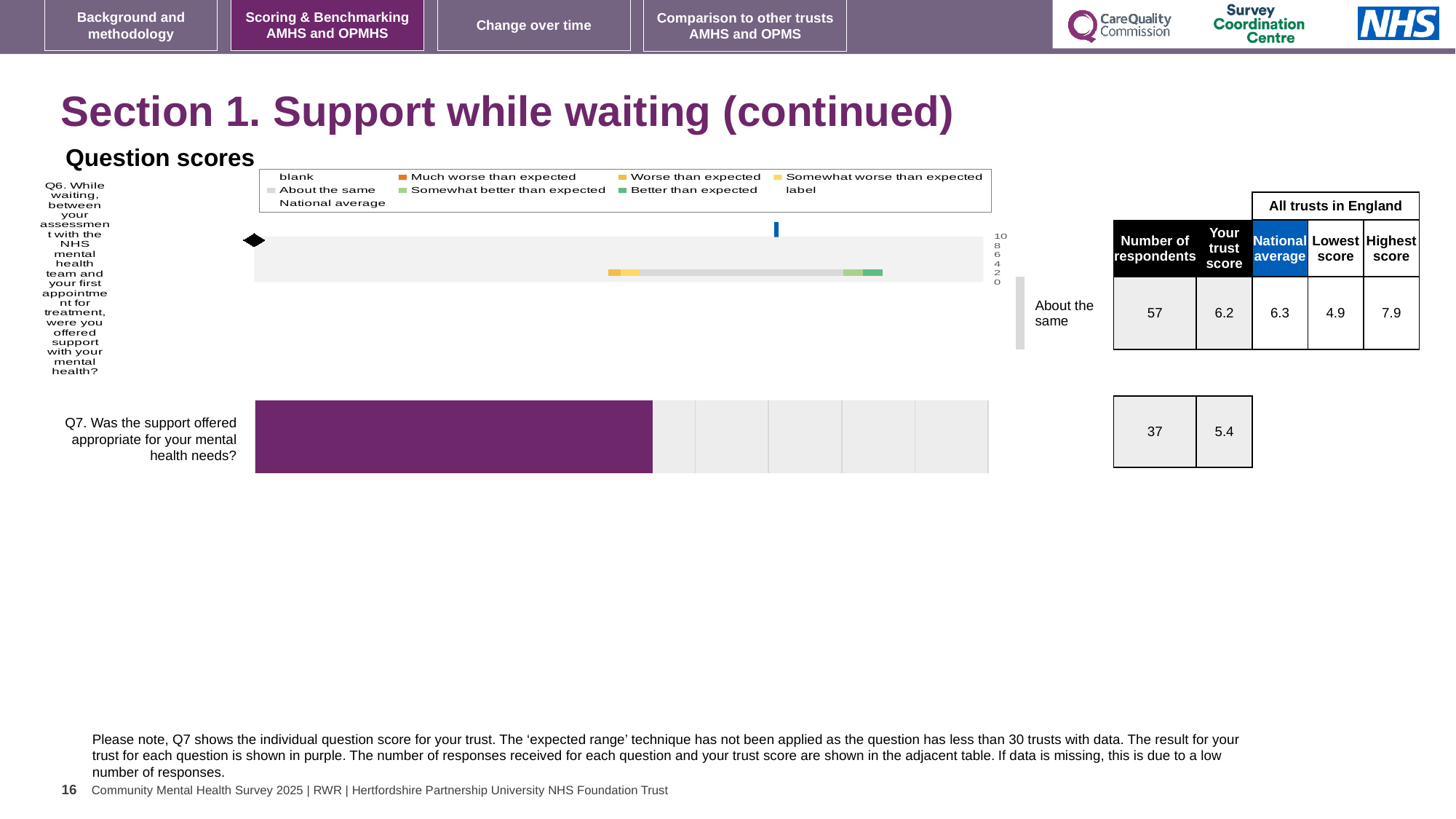
Which question has the higher trust score, Q6 or Q7? Q6 What kind of chart is used to show the question scores? Bar chart How many respondents answered Q6? 57 What is the highest score among all trusts in England for Q6? 7.9 How many questions are plotted in the Question scores chart? 2 How many respondents answered Q7? 37 What is the difference between the highest and lowest trust scores for Q6? 3.0 What is the national average score for Q6? 6.3 What is the trust score for Q7 (was the support offered appropriate for your mental health needs)? 5.4 Which expected-range category does the trust's Q6 score fall into? About the same What is the trust score for Q6 (support while waiting between assessment and first appointment)? 6.2 What is the lowest score among all trusts in England for Q6? 4.9